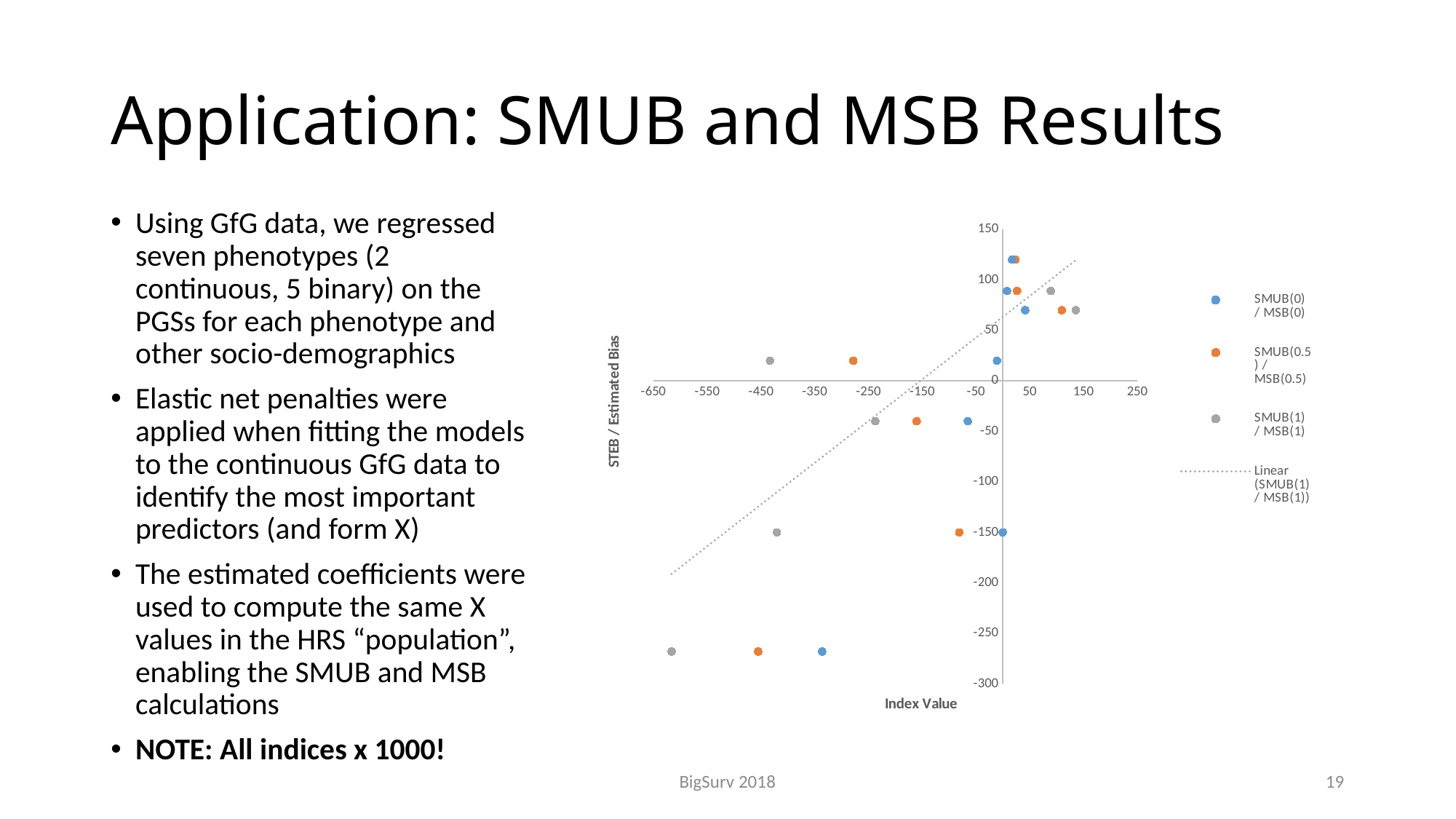
What kind of chart is shown on the slide? scatter chart Is the smallest Index Value among the SMUB(1) / MSB(1) points greater or less than -550? less How many entries does the chart's legend list? 4 Is the largest Index Value among the SMUB(1) / MSB(1) points greater or less than 50? greater Which series is plotted in grey in the chart? SMUB(1) / MSB(1) Is the highest STEB / Estimated Bias value among the SMUB(0.5) / MSB(0.5) points greater or less than 100? greater Which series contains the point with the lowest Index Value in the chart? SMUB(1) / MSB(1) What is the title of the horizontal axis of the chart? Index Value Does the dotted linear trendline for SMUB(1) / MSB(1) slope upward or downward as Index Value increases? upward